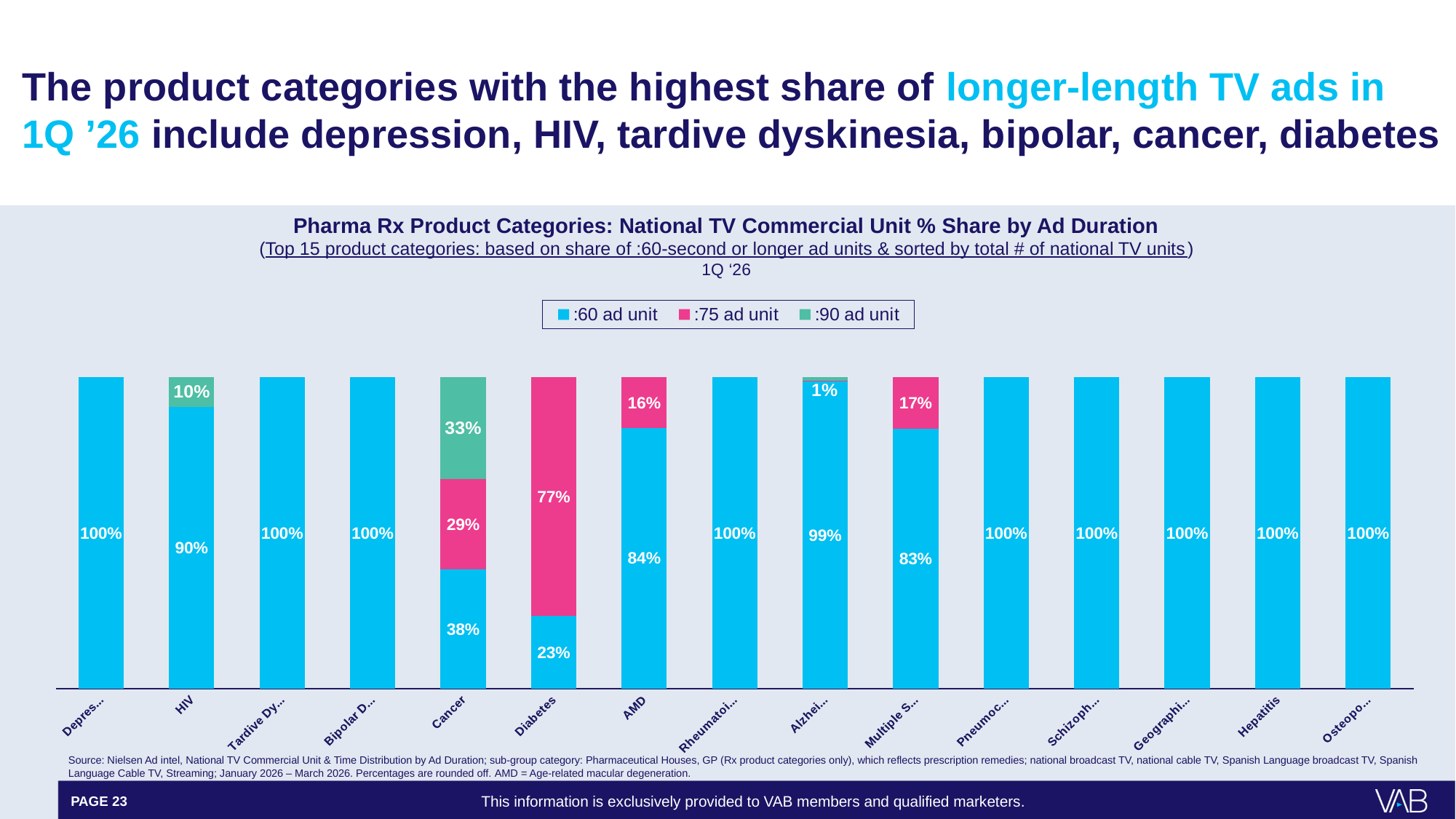
Which product category has the lowest :60 ad unit share? Diabetes Which product category has the highest :75 ad unit share? Diabetes What is the :90 ad unit share for HIV? 10% How many series does the legend list? 3 How many product categories are plotted on the chart? 15 Which has a larger :60 ad unit share, HIV or AMD? HIV What is the :60 ad unit share for Hepatitis? 100% For Cancer, what is the difference between the :60 ad unit share and the :75 ad unit share? 9 percentage points What is the :60 ad unit share for Cancer? 38% What is the :60 ad unit share for AMD? 84% What kind of chart is shown on the slide? Stacked bar chart What is the :75 ad unit share for Diabetes? 77%